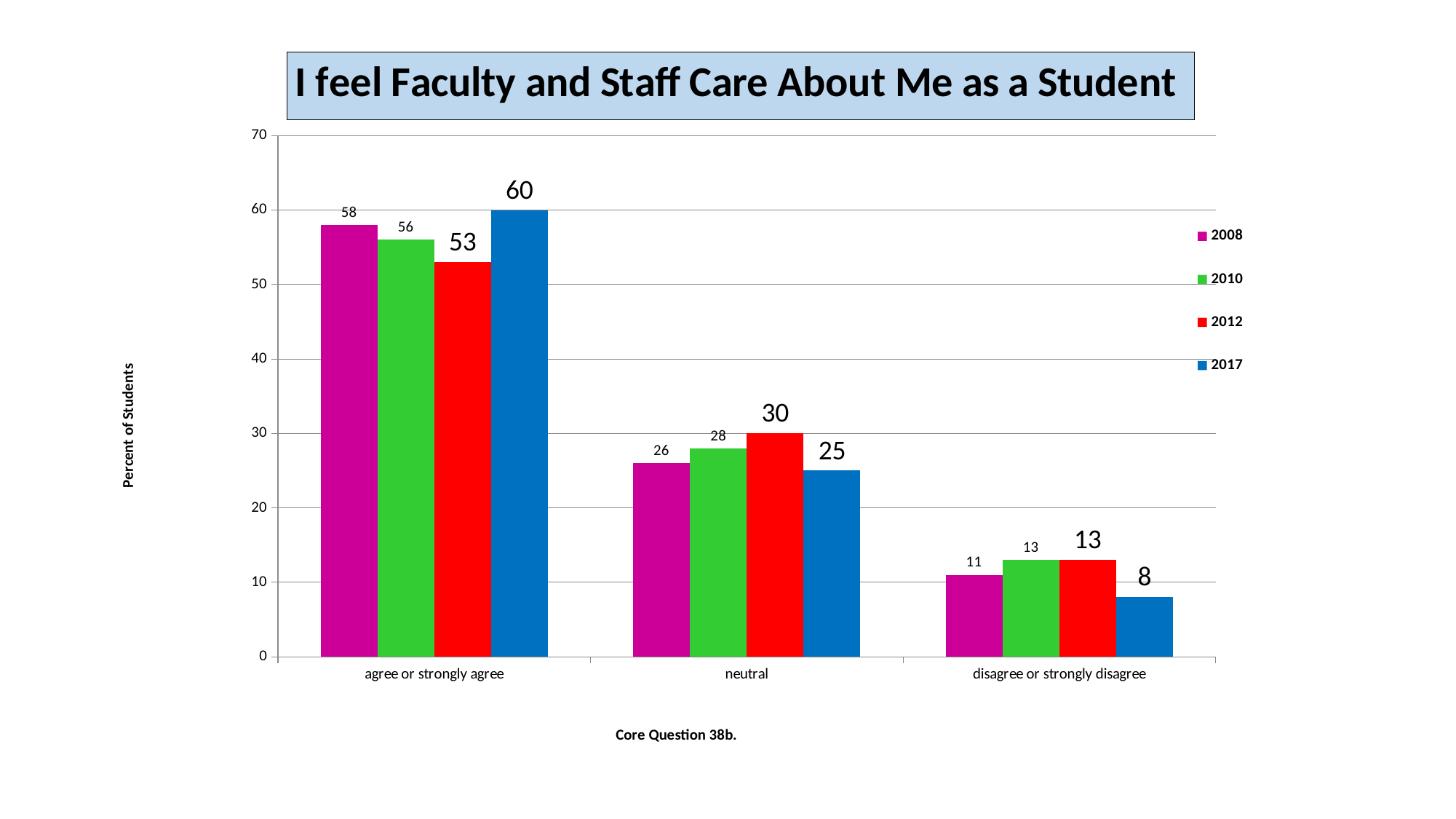
Which year has the lowest value in the 'disagree or strongly disagree' category? 2017 How many series does the legend list? 4 How many categories are shown on the x axis? 3 What is the title of the chart? I feel Faculty and Staff Care About Me as a Student What kind of chart is shown on the slide? bar chart Which year has the highest value in the 'agree or strongly agree' category? 2017 Is the value for 2008 in the 'neutral' category greater or less than 30? less What is the value for 2017 in the 'agree or strongly agree' category? 60 Which is larger in the 'neutral' category: the value for 2010 or the value for 2017? 2010 What is the value for 2012 in the 'neutral' category? 30 What is the difference between the 2017 and 2012 values in the 'agree or strongly agree' category? 7 What is the value for 2008 in the 'disagree or strongly disagree' category? 11